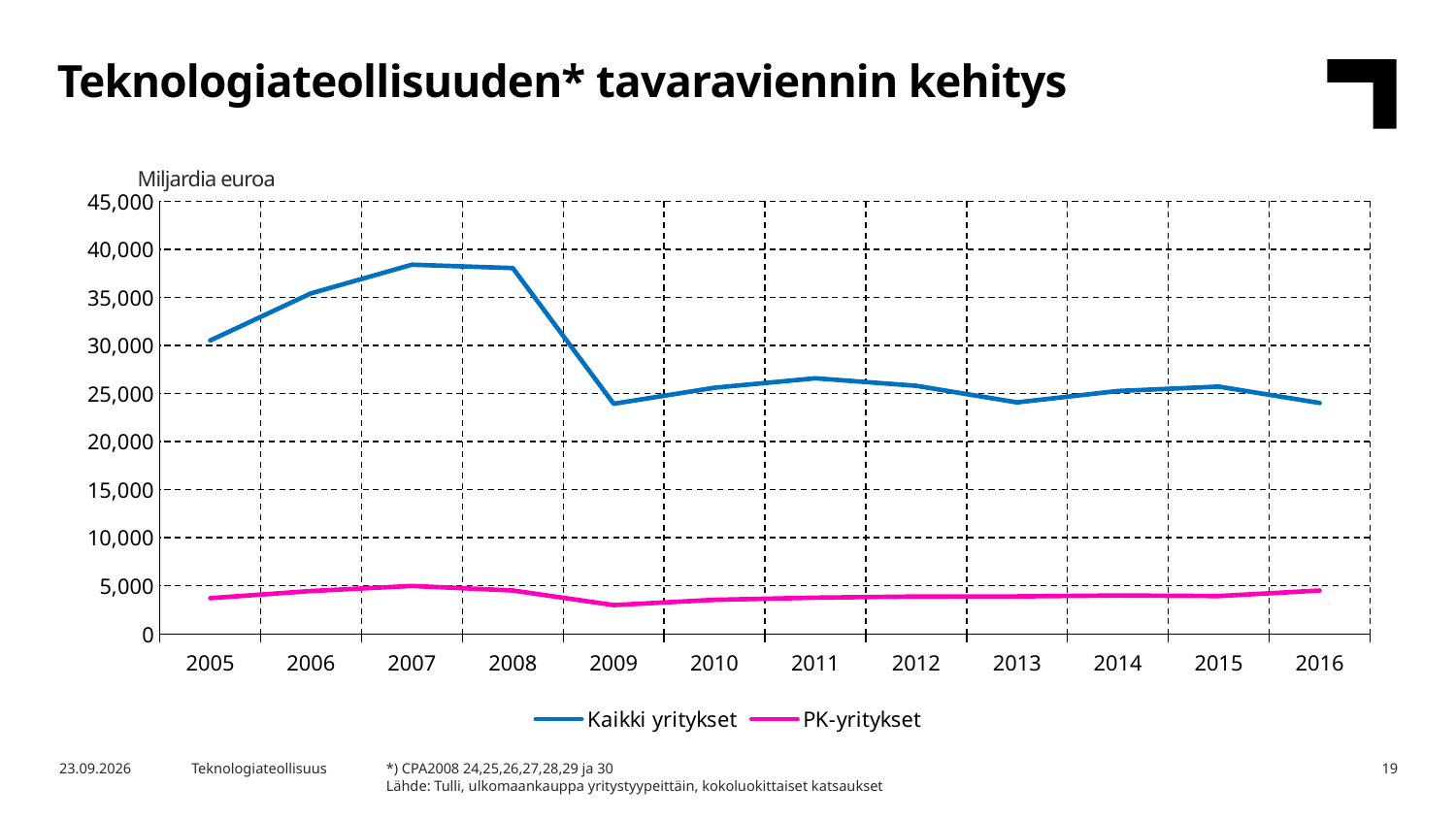
How many series does the legend list? 2 Is the value for Kaikki yritykset in 2007 greater or less than 35,000? greater Does the Kaikki yritykset series rise or fall between 2008 and 2009? Fall In which year does the Kaikki yritykset series reach its highest value? 2007 What unit label is shown above the vertical axis? Miljardia euroa Is the value for Kaikki yritykset in 2009 greater or less than 25,000? less Which is larger for Kaikki yritykset: the value in 2007 or the value in 2009? 2007 How many years are plotted along the x axis? 12 Is the value for PK-yritykset in 2005 greater or less than 5,000? less Does the Kaikki yritykset series rise or fall between 2005 and 2007? Rise In which year does the PK-yritykset series reach its lowest value? 2009 What kind of chart is shown on the slide? Line chart